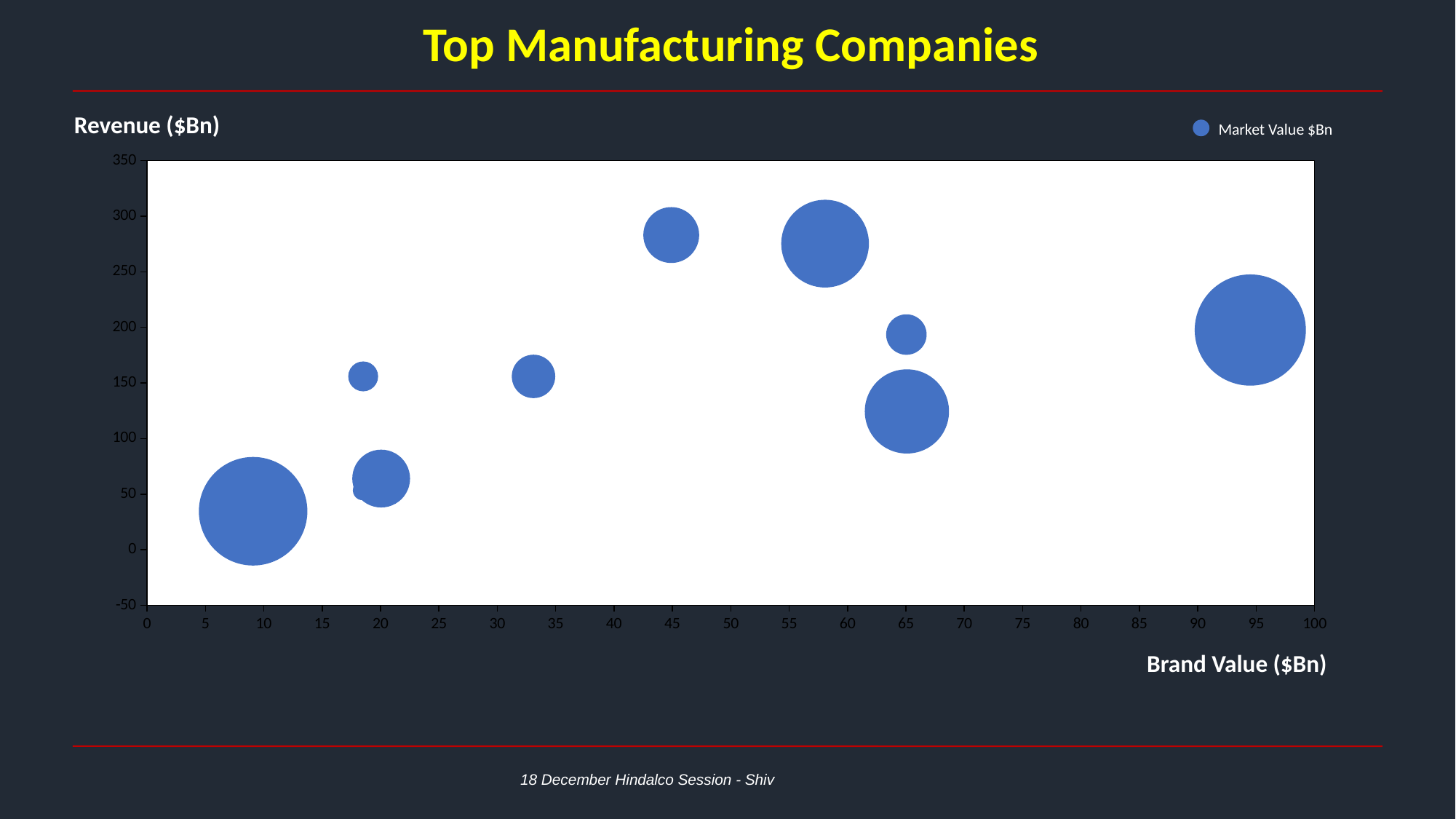
What is the legend entry for the plotted series? Market Value $Bn Is the brand value of the rightmost bubble greater or less than 90? greater Is the revenue of the rightmost bubble greater or less than 250? less Is the brand value of the bubble with the highest revenue greater or less than 50? less Which has the higher revenue, the leftmost bubble or the rightmost bubble? the rightmost bubble How many bubbles have a revenue above 250? 2 How many series does the legend list? 1 What kind of chart is shown on the slide? bubble chart What is the label of the horizontal axis? Brand Value ($Bn)